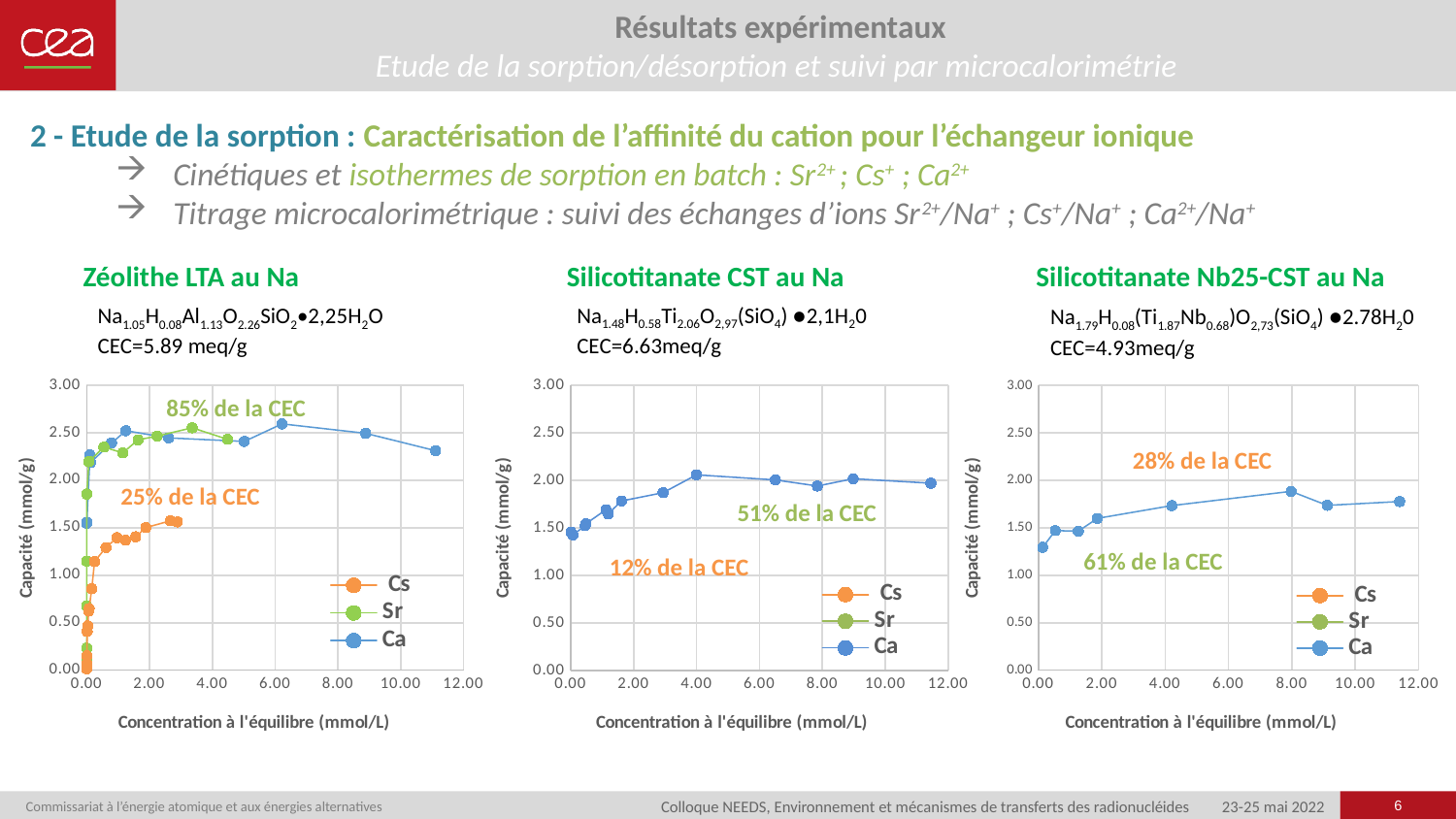
In the 'Silicotitanate CST au Na' chart, is the value for Ca at a concentration of 4.00 mmol/L greater or less than 1.50 mmol/g? greater In the 'Zéolithe LTA au Na' chart, how many series does the legend list? 3 In the 'Zéolithe LTA au Na' chart, which series has the lowest capacity values overall? Cs What kind of chart is the 'Silicotitanate Nb25-CST au Na' chart? line chart How many charts are shown on the slide? 3 In the 'Zéolithe LTA au Na' chart, is the value for Sr at a concentration of 2.00 mmol/L greater or less than 2.00 mmol/g? greater In the 'Silicotitanate CST au Na' chart, does the Ca capacity rise or fall as concentration increases from 0.00 to 4.00 mmol/L? rise In the 'Zéolithe LTA au Na' chart, which series has the larger capacity at a concentration of 2.00 mmol/L, Cs or Sr? Sr What is the y-axis label of the 'Silicotitanate Nb25-CST au Na' chart? Capacité (mmol/g) In the 'Silicotitanate Nb25-CST au Na' chart, is the value for Ca at a concentration of 8.00 mmol/L greater or less than 2.00 mmol/g? less In the 'Silicotitanate CST au Na' chart, what are the legend entries? Cs, Sr, Ca